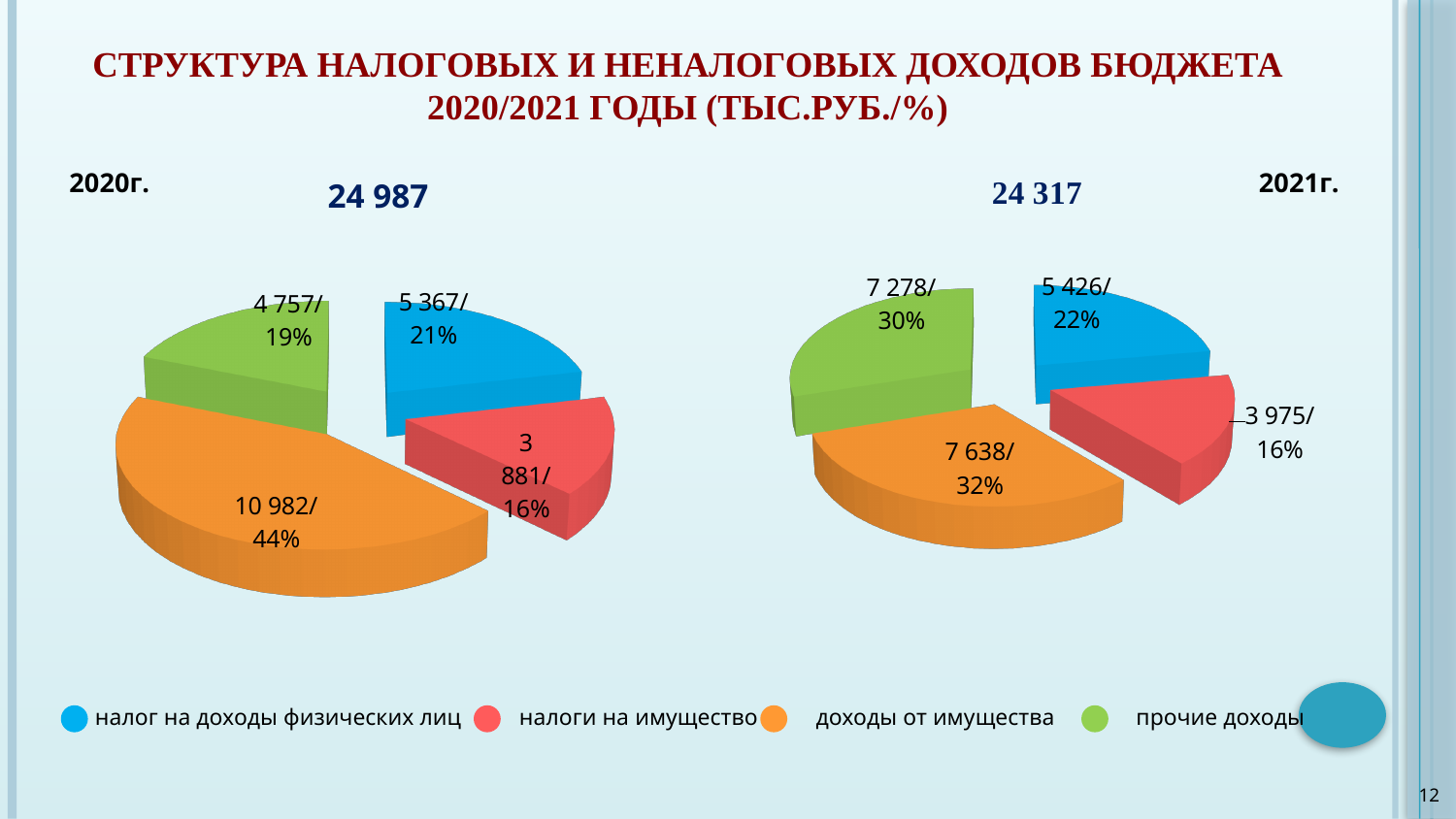
How many categories does the legend list? 4 In the 2021г. pie chart, what share of the total is доходы от имущества? 32% What type of chart is used on the slide for the 2020г. data? pie chart What total is shown above the 2021г. pie chart? 24 317 In the 2020г. pie chart, what value is shown for доходы от имущества? 10 982/44% In the 2020г. pie chart, which category has the smallest slice? налоги на имущество In the 2021г. pie chart, which is larger: прочие доходы or налог на доходы физических лиц? прочие доходы In the 2021г. pie chart, what value is shown for прочие доходы? 7 278/30% In the 2021г. pie chart, what value is shown for налог на доходы физических лиц? 5 426/22% In the 2021г. pie chart, which category has the smallest slice? налоги на имущество In the 2020г. pie chart, which category has the largest slice? доходы от имущества In the 2020г. pie chart, what is the difference in thousand rubles between доходы от имущества and налог на доходы физических лиц? 5 615